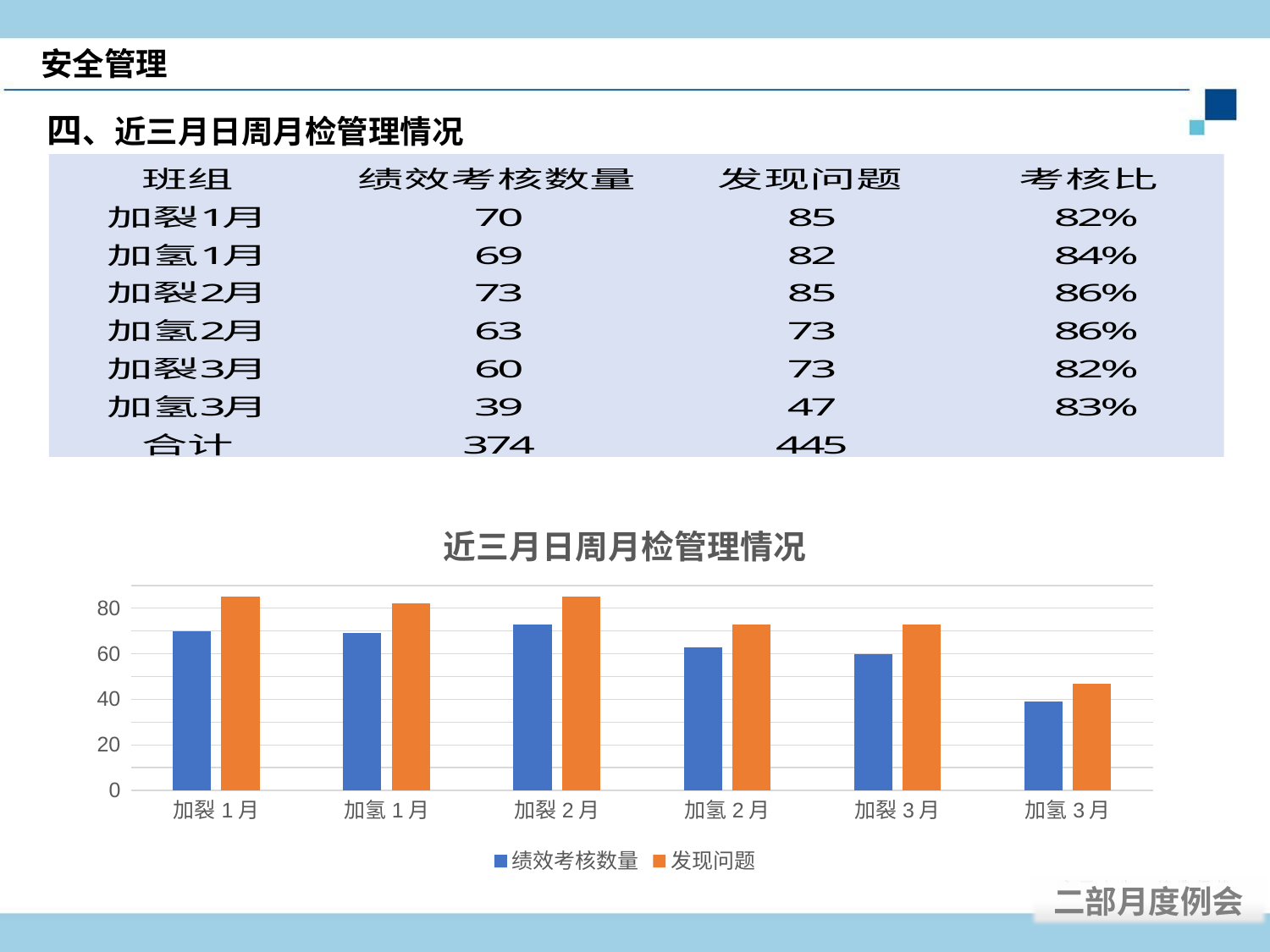
What is the difference between 发现问题 and 绩效考核数量 for 加裂1月? 15 For 加氢2月, which is larger: 绩效考核数量 or 发现问题? 发现问题 Which category has the lowest 发现问题 value? 加氢3月 What kind of chart is shown on the slide? bar chart Which category has the lowest 绩效考核数量 value? 加氢3月 How many series does the chart legend list? 2 Is the 绩效考核数量 value for 加氢1月 greater or less than 60? greater What is the 绩效考核数量 value for 加裂1月? 70 Which colour represents 发现问题 in the chart? orange What is the title of the chart? 近三月日周月检管理情况 What is the 发现问题 value for 加氢3月? 47 How many categories are shown on the x axis of the chart? 6